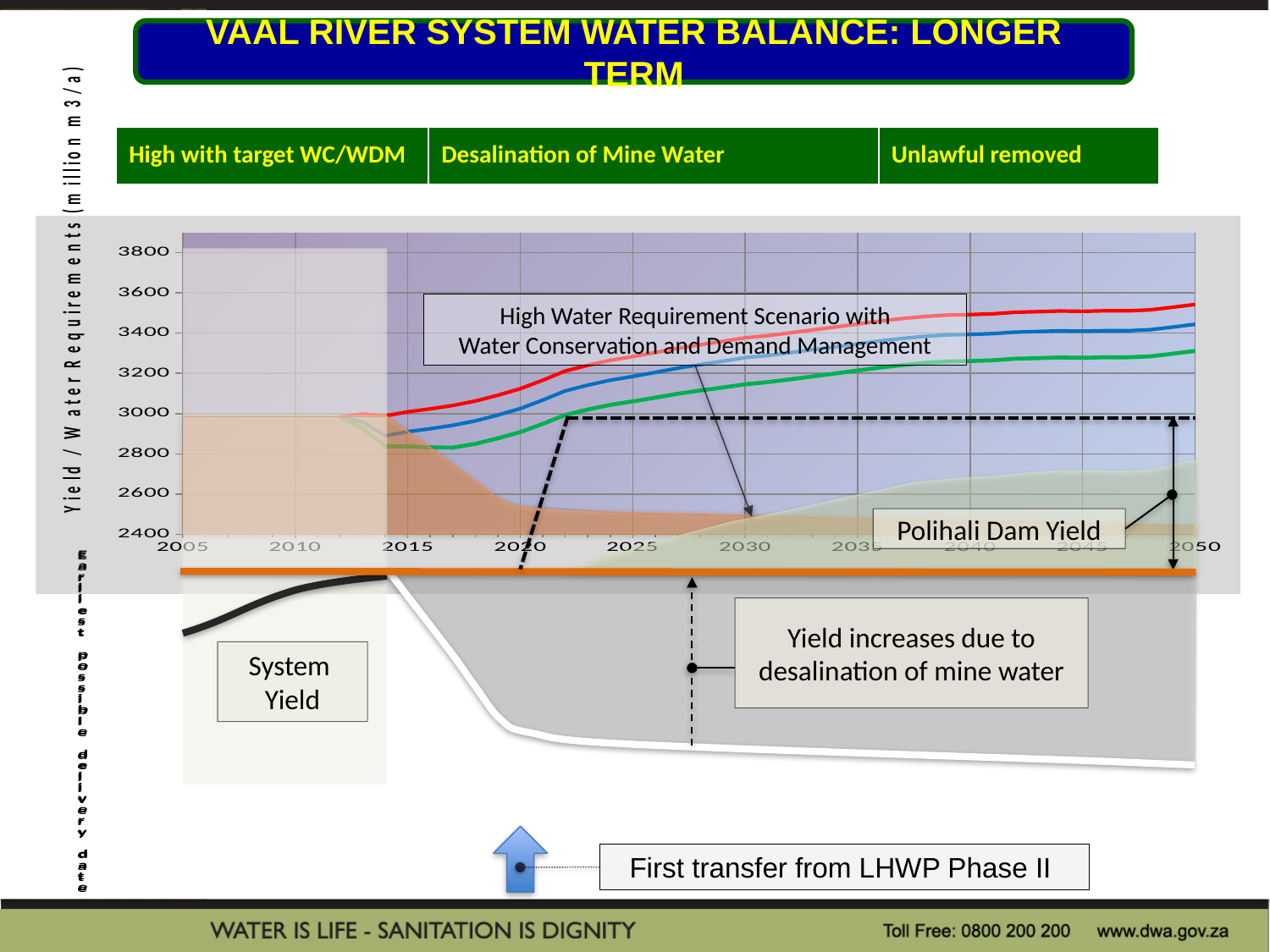
What is the highest value shown on the vertical axis of the chart? 3800 At 2050, which line is higher, the red line or the green line? red line What is the title of the slide's chart? VAAL RIVER SYSTEM WATER BALANCE: LONGER TERM How many year ticks are shown on the horizontal axis of the chart? 10 Is the value of the red line at 2025 greater or less than 3000? greater Does the green line rise or fall between 2020 and 2050? rise What kind of chart is shown on the slide? line chart Does the red line rise or fall between 2015 and 2050? rise Is the value of the green line at 2050 greater or less than 3200? greater Is the value of the red line at 2050 greater or less than 3400? greater What is the label on the vertical axis of the chart? Yield / Water Requirements (million m3/a)